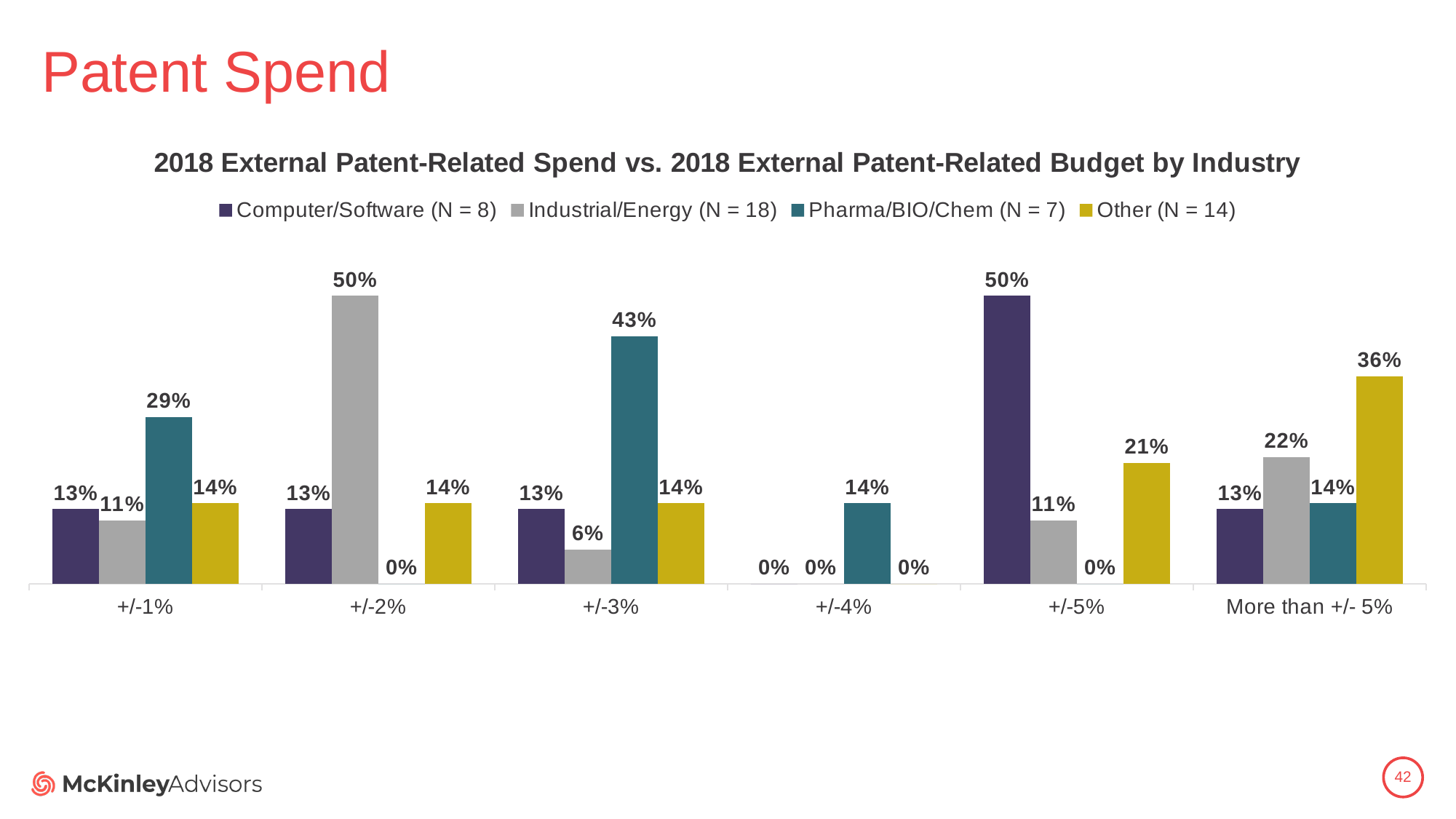
What is the difference between the Other value and the Industrial/Energy value in the +/-5% category? 10% What is the value for Computer/Software in the +/-5% category? 50% Which is larger in the More than +/- 5% category: Industrial/Energy or Pharma/BIO/Chem? Industrial/Energy How many series does the legend list? 4 Which series has the highest value in the +/-1% category? Pharma/BIO/Chem What kind of chart is shown on the slide? Bar chart How many categories are shown on the x axis? 6 Which series has the lowest value in the +/-3% category? Industrial/Energy What is the value for Industrial/Energy in the +/-2% category? 50% What is the sample size (N) for the Industrial/Energy series in the legend? 18 What is the value for Other in the More than +/- 5% category? 36% What is the value for Pharma/BIO/Chem in the +/-3% category? 43%